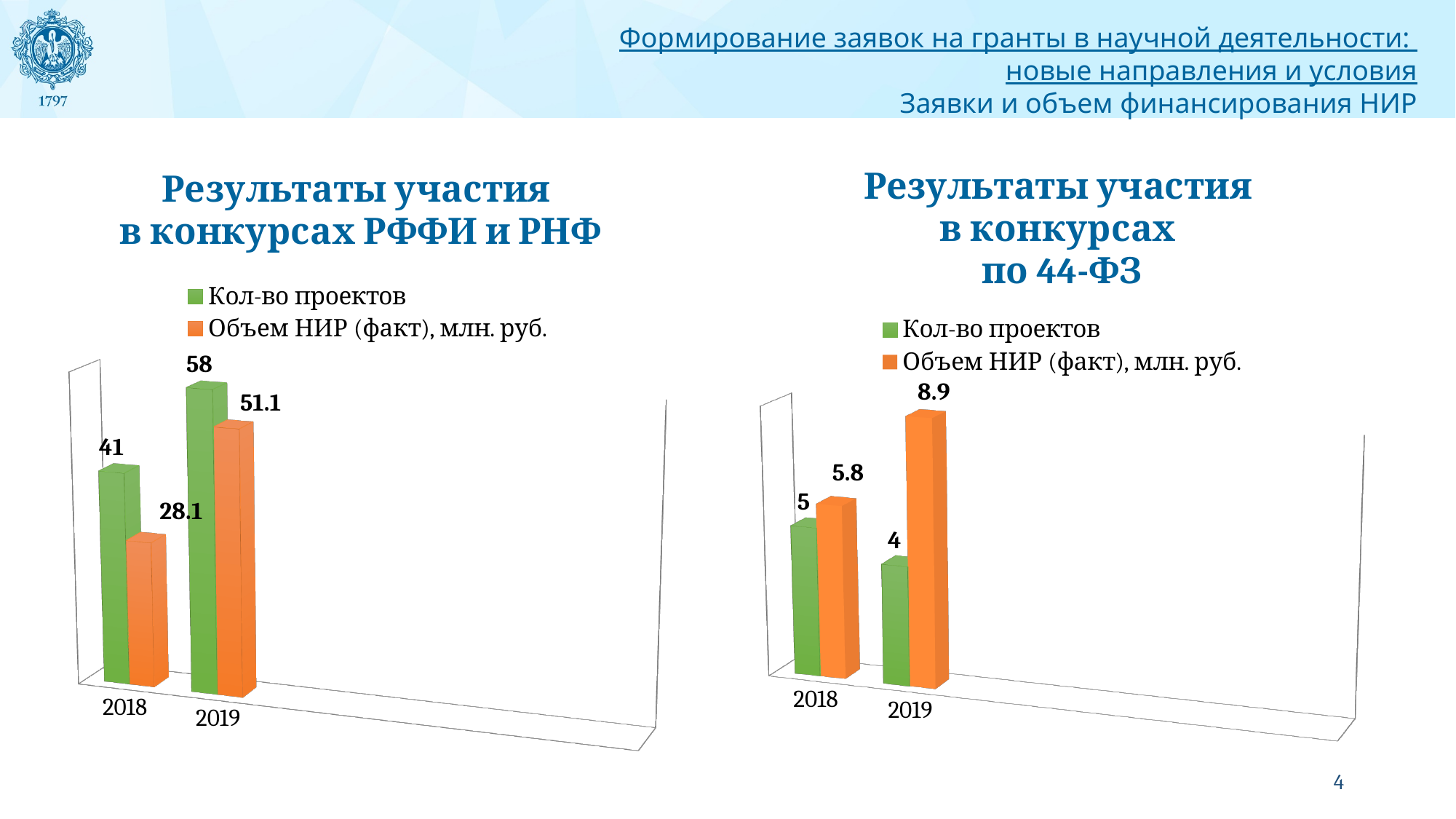
What type of chart is the right chart (Результаты участия в конкурсах по 44-ФЗ)? bar chart In the left chart (Результаты участия в конкурсах РФФИ и РНФ), what is the difference in Объем НИР (факт), млн. руб. between 2019 and 2018? 23 In the left chart (Результаты участия в конкурсах РФФИ и РНФ), what is the value of Кол-во проектов for 2019? 58 In the left chart (Результаты участия в конкурсах РФФИ и РНФ), does Объем НИР (факт) rise or fall from 2018 to 2019? rise In the right chart (Результаты участия в конкурсах по 44-ФЗ), what is the value of Кол-во проектов for 2018? 5 In the left chart (Результаты участия в конкурсах РФФИ и РНФ), what is the value of Объем НИР (факт), млн. руб. for 2018? 28.1 How many series does the legend of the left chart (Результаты участия в конкурсах РФФИ и РНФ) list? 2 In the right chart (Результаты участия в конкурсах по 44-ФЗ), what is the difference in Объем НИР (факт), млн. руб. between 2019 and 2018? 3.1 In the right chart (Результаты участия в конкурсах по 44-ФЗ), which year has the lower Кол-во проектов? 2019 In the right chart (Результаты участия в конкурсах по 44-ФЗ), what is the value of Объем НИР (факт), млн. руб. for 2019? 8.9 In the left chart (Результаты участия в конкурсах РФФИ и РНФ), by how much did Кол-во проектов increase from 2018 to 2019? 17 In the right chart (Результаты участия в конкурсах по 44-ФЗ), does Кол-во проектов rise or fall from 2018 to 2019? fall